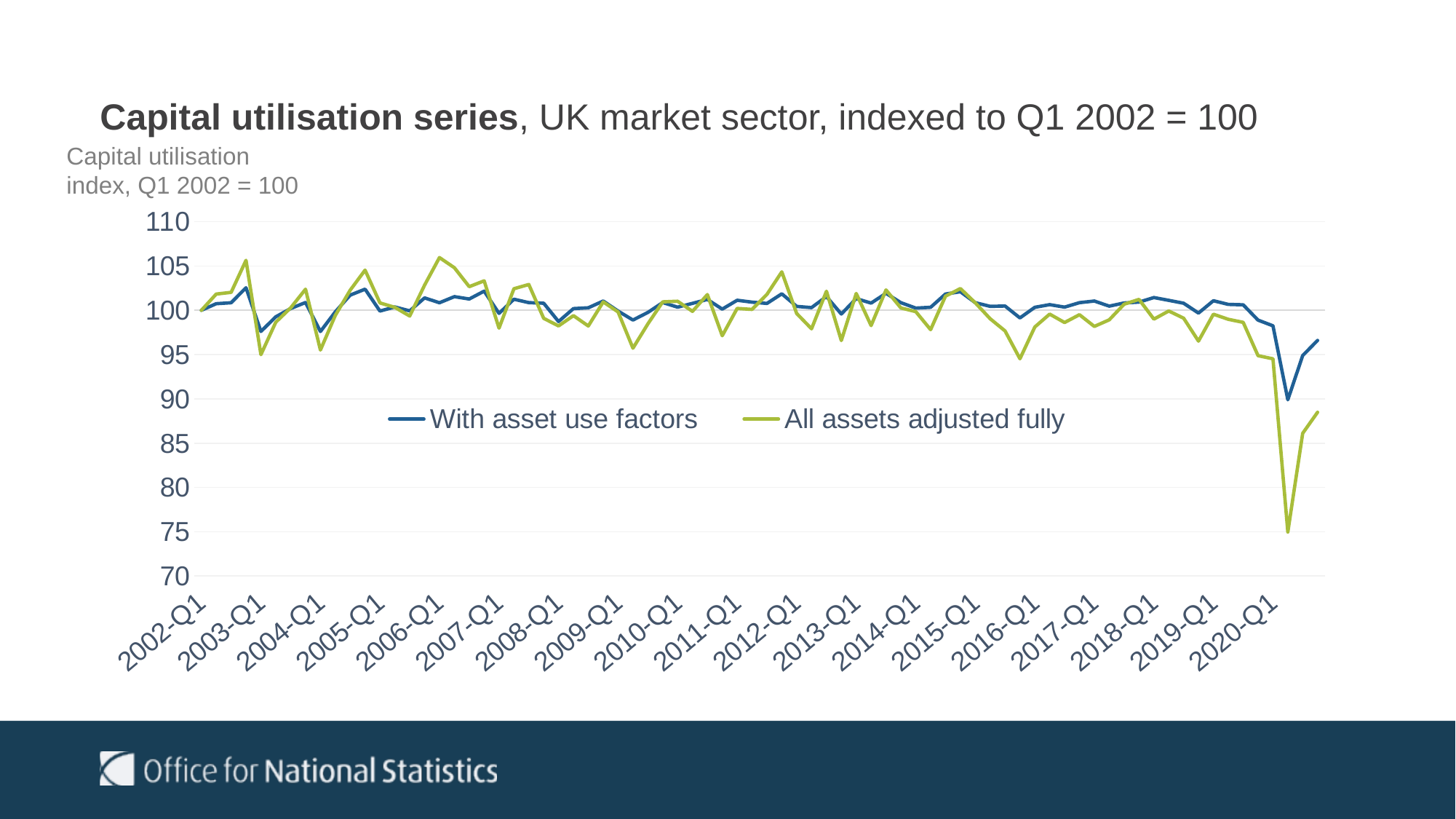
Is the highest value of the 'All assets adjusted fully' series greater or less than 100? greater Do both series rise or fall sharply at the end of the period, after 2020-Q1? Fall What are the two series named in the legend? With asset use factors; All assets adjusted fully What kind of chart is shown on the slide? Line chart What is the title of the chart? Capital utilisation series, UK market sector, indexed to Q1 2002 = 100 Is the lowest value of the 'With asset use factors' series, reached in 2020, greater or less than 95? less Is the lowest value of the 'All assets adjusted fully' series, reached in 2020, greater or less than 80? less How many year labels are shown on the x axis? 19 What is the value of both series at 2002-Q1, the base period of the index? 100 How many series does the legend list? 2 Which series falls to a lower value in 2020, 'With asset use factors' or 'All assets adjusted fully'? All assets adjusted fully